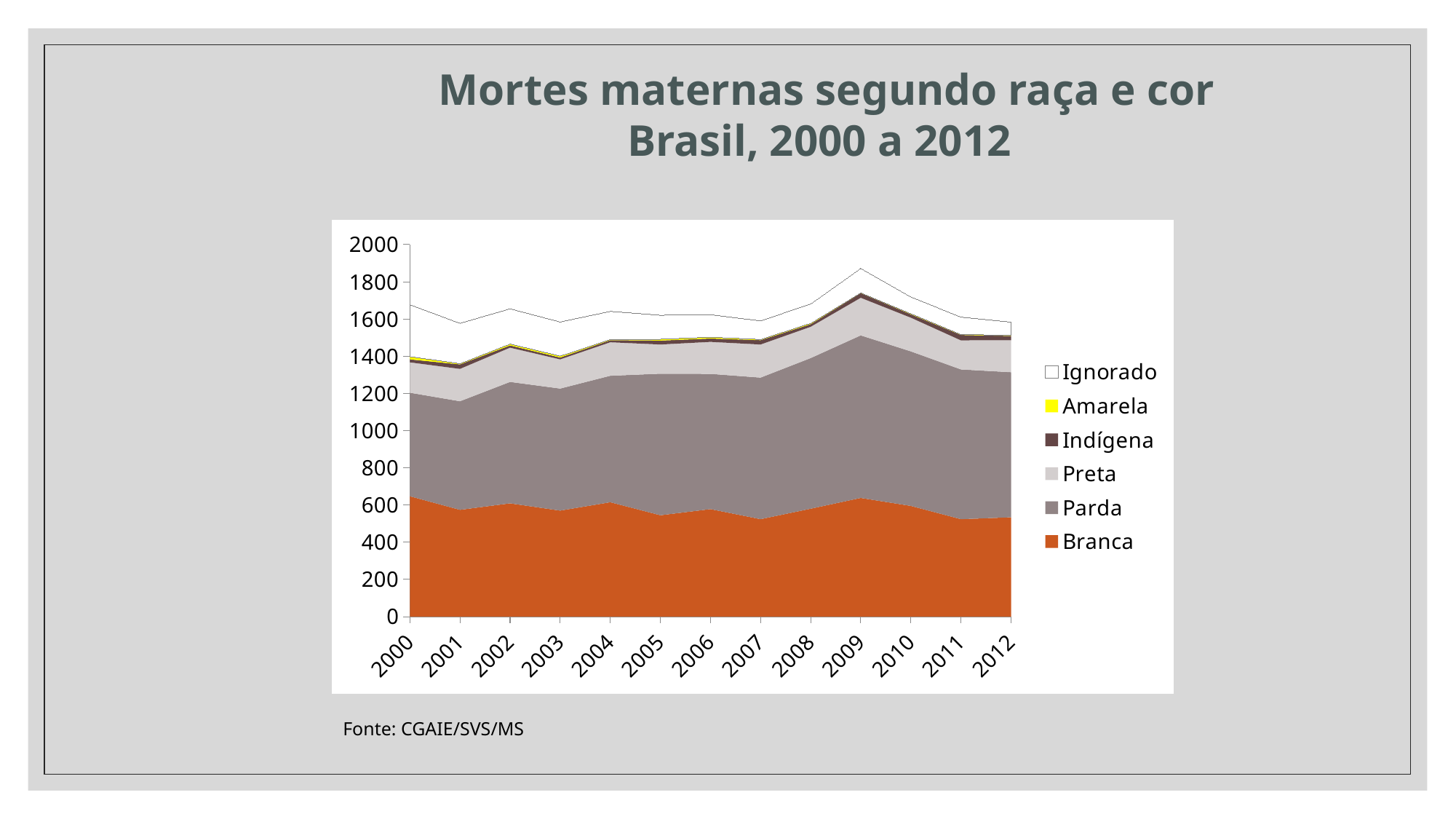
Is the total of all series in 2001 greater or less than 1600? less Which series is plotted at the bottom of the stack? Branca Is the value for Branca in 2007 greater or less than 600? less How many years are shown along the x axis? 13 Which year has the larger total of all series, 2009 or 2001? 2009 What is the title of the chart? Mortes maternas segundo raça e cor Brasil, 2000 a 2012 What kind of chart is shown on the slide? stacked area chart Is the total of all series in 2009 greater or less than 1800? greater In which year is the total number of maternal deaths highest? 2009 How many series does the legend list? 6 Does the total of all series rise or fall from 2009 to 2012? fall